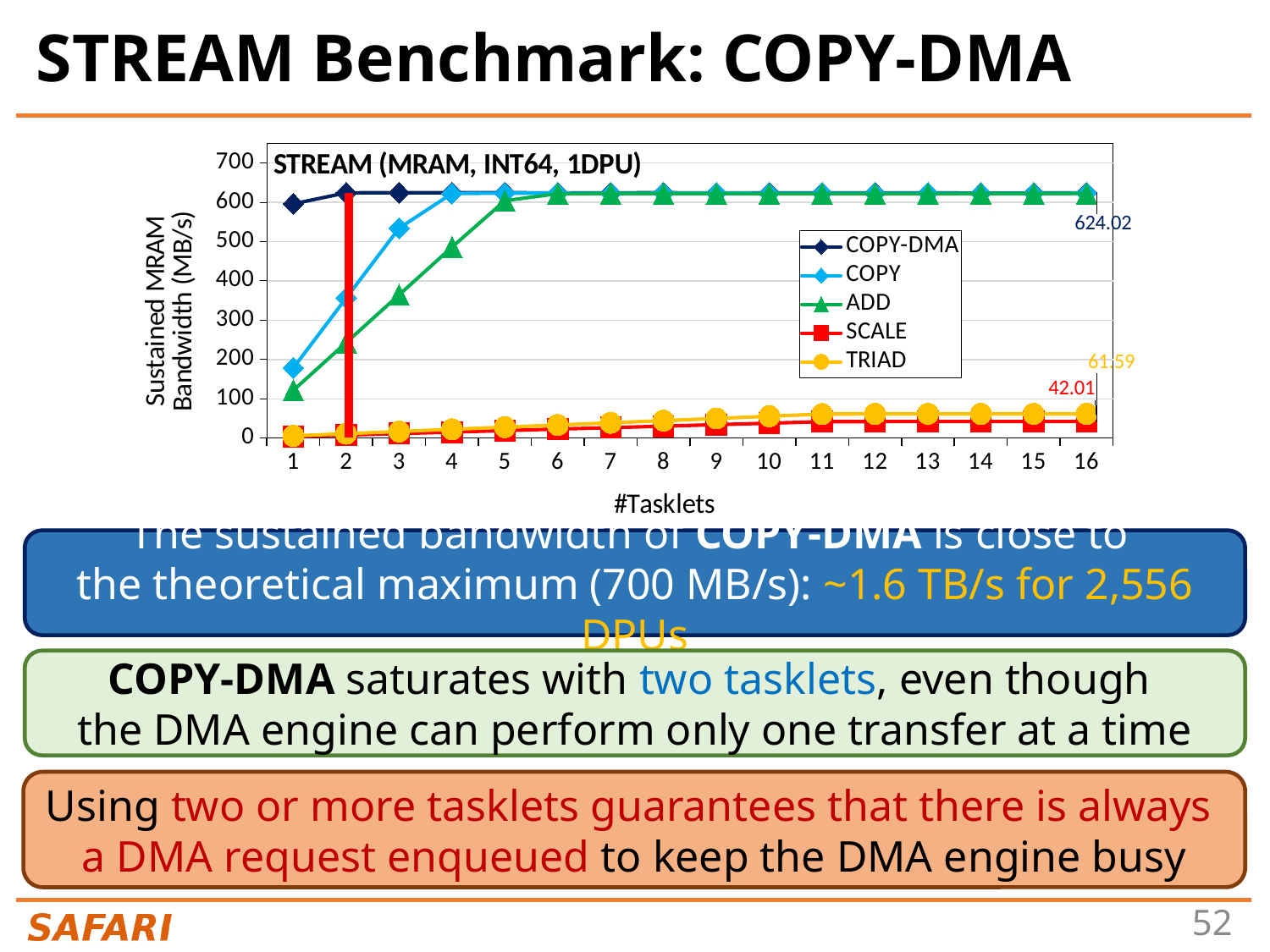
How many #Tasklets values are plotted along the x axis? 16 Which series has the lowest bandwidth at 16 tasklets? SCALE Is the value for COPY-DMA at 1 tasklet greater or less than 500? greater How many series does the legend list? 5 What is the sustained bandwidth of TRIAD at 16 tasklets? 61.59 What is the difference between the TRIAD and SCALE values at 16 tasklets? 19.58 What is the title of the chart? STREAM (MRAM, INT64, 1DPU) Is the value for ADD at 1 tasklet greater or less than 200? less What is the sustained bandwidth of COPY-DMA at 16 tasklets? 624.02 At 16 tasklets, which has the higher bandwidth, TRIAD or SCALE? TRIAD What is the sustained bandwidth of SCALE at 16 tasklets? 42.01 What kind of chart is shown on the slide? line chart